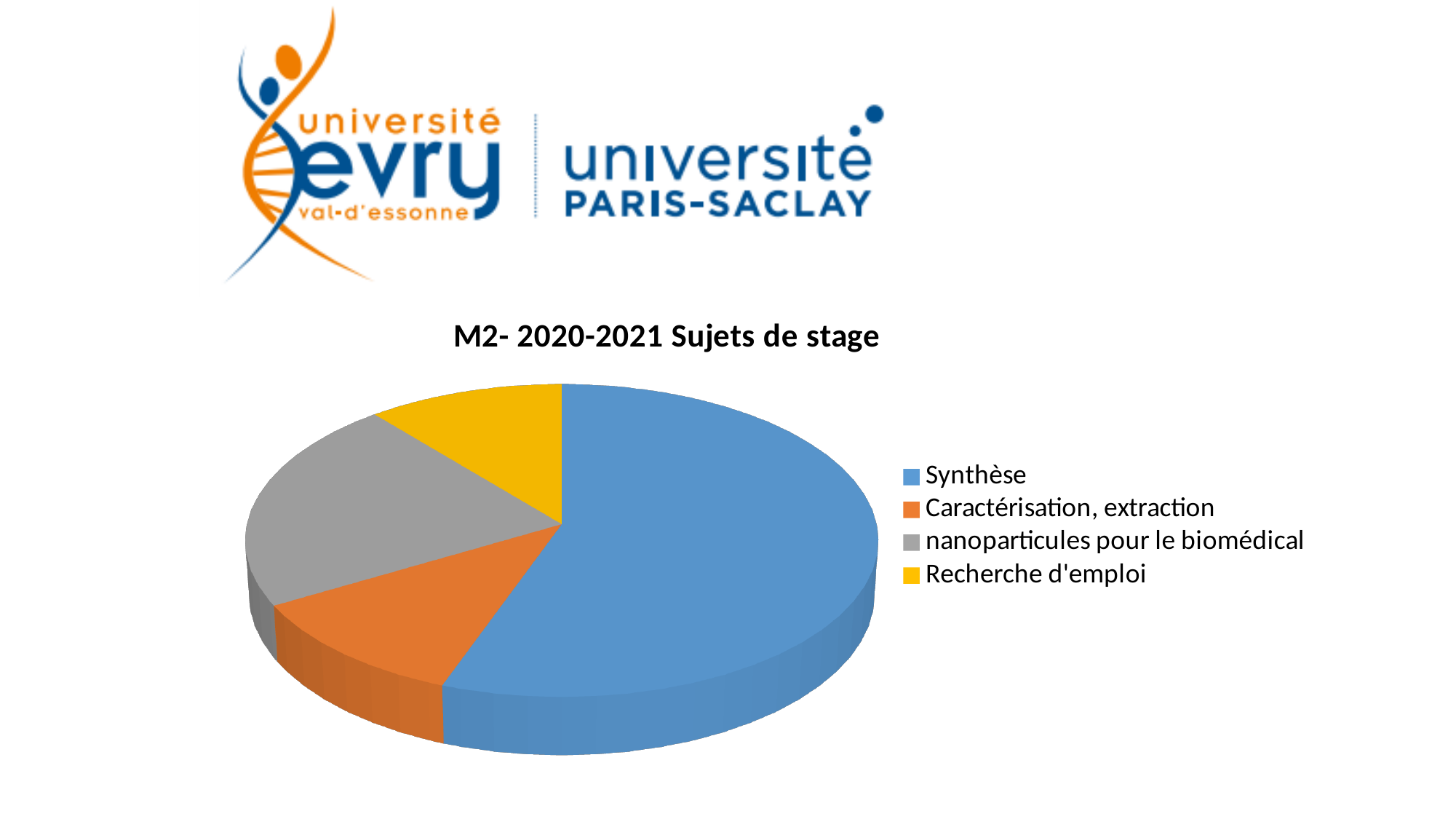
Which colour represents Recherche d'emploi in the pie chart? yellow Which slice is larger, Synthèse or nanoparticules pour le biomédical? Synthèse What is the title of the chart? M2- 2020-2021 Sujets de stage Which slice is larger, nanoparticules pour le biomédical or Recherche d'emploi? nanoparticules pour le biomédical What kind of chart is shown on the slide? pie chart Which slice is larger, Synthèse or Caractérisation, extraction? Synthèse Which category has the largest slice of the pie? Synthèse How many slices does the pie chart have? 4 How many entries does the legend list? 4